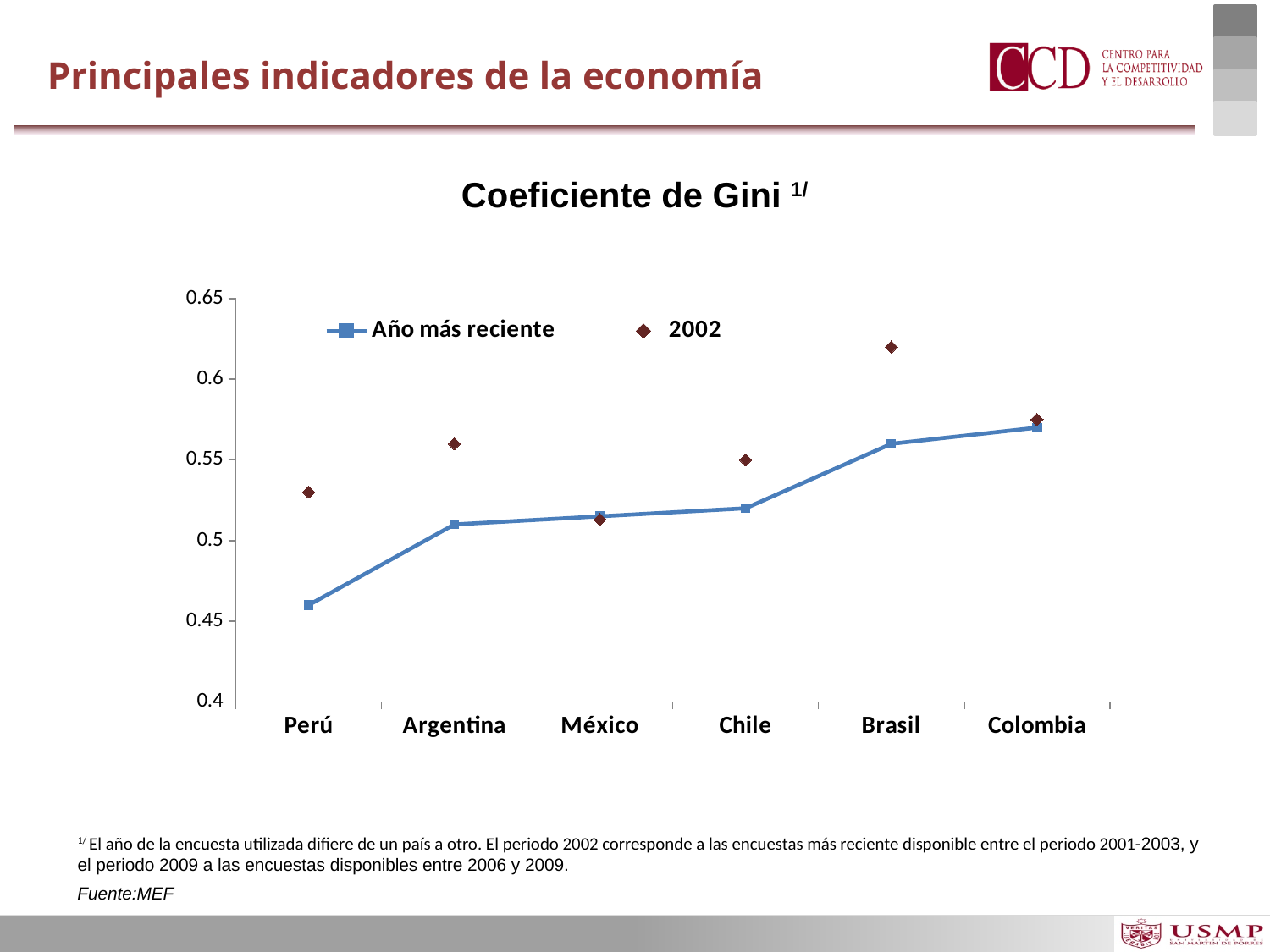
How many countries are shown on the x axis of the chart? 6 How many series does the chart legend list? 2 Which country has the highest value for the '2002' series? Brasil Is the 'Año más reciente' value for Perú greater or less than 0.5? less For Perú, which series has the larger value: 'Año más reciente' or '2002'? 2002 What is the title of the chart? Coeficiente de Gini What kind of chart is shown on the slide? line chart Is the 'Año más reciente' value for Chile greater or less than 0.55? less Which country has the lowest value for the 'Año más reciente' series? Perú Does the 'Año más reciente' series rise or fall from Perú to Colombia along the x axis? rise Is the '2002' value for Brasil greater or less than 0.6? greater